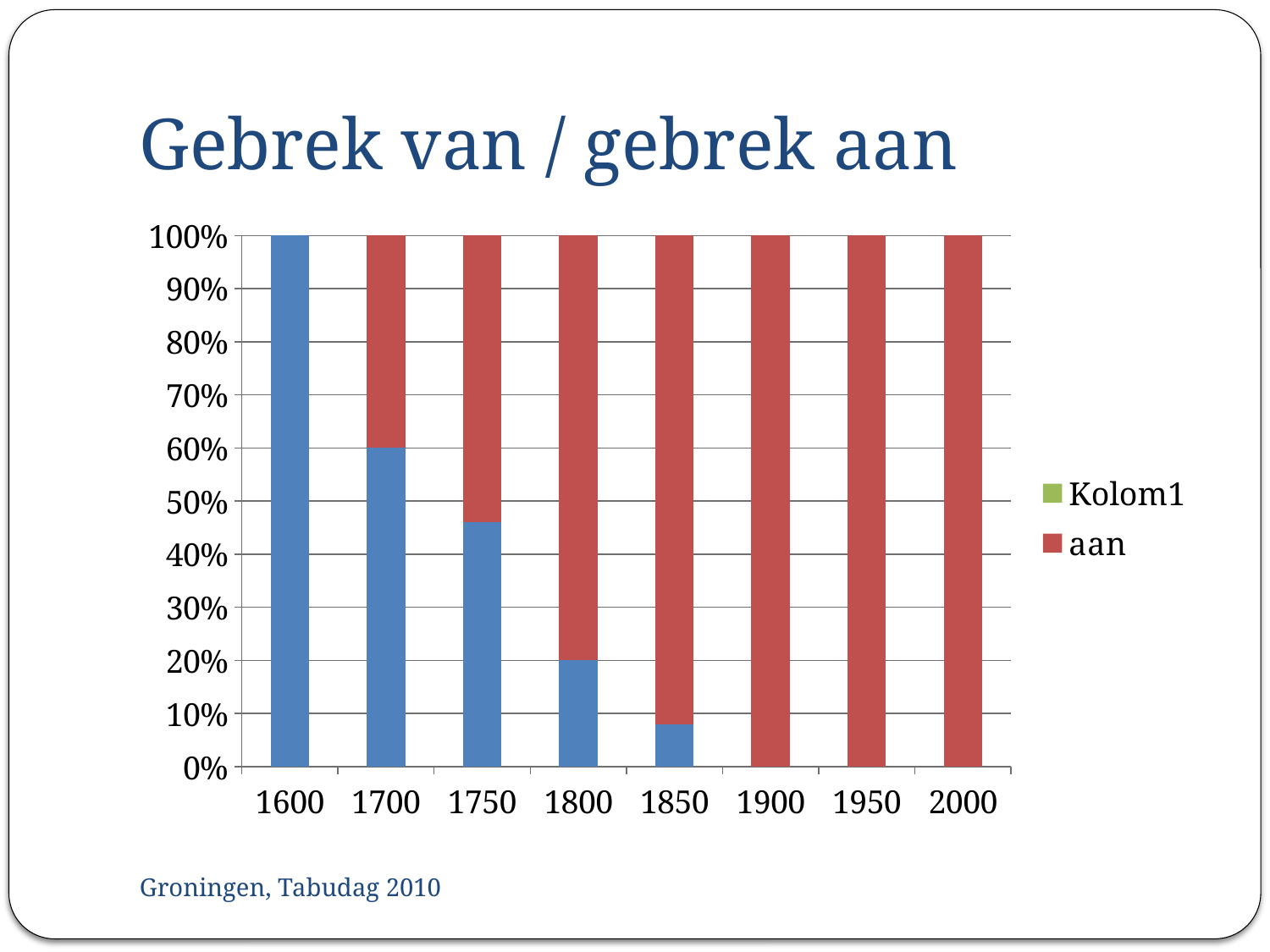
Which year has the larger blue segment, 1700 or 1800? 1700 What is the title of the slide containing the chart? Gebrek van / gebrek aan Does the blue share of the bars rise or fall from 1600 to 2000? Fall What share of the bar for 1600 is blue? 100% Which series names appear in the chart legend? Kolom1 and aan Up to what percentage does the blue segment for 1800 reach? 20% Up to what percentage does the blue segment for 1700 reach? 60% How many series does the chart legend list? 2 Is the blue segment for 1750 greater or less than 50%? less Is the blue segment for 1850 greater or less than 10%? less What kind of chart is shown on the slide? Stacked bar chart How many years are shown on the x axis of the chart? 8